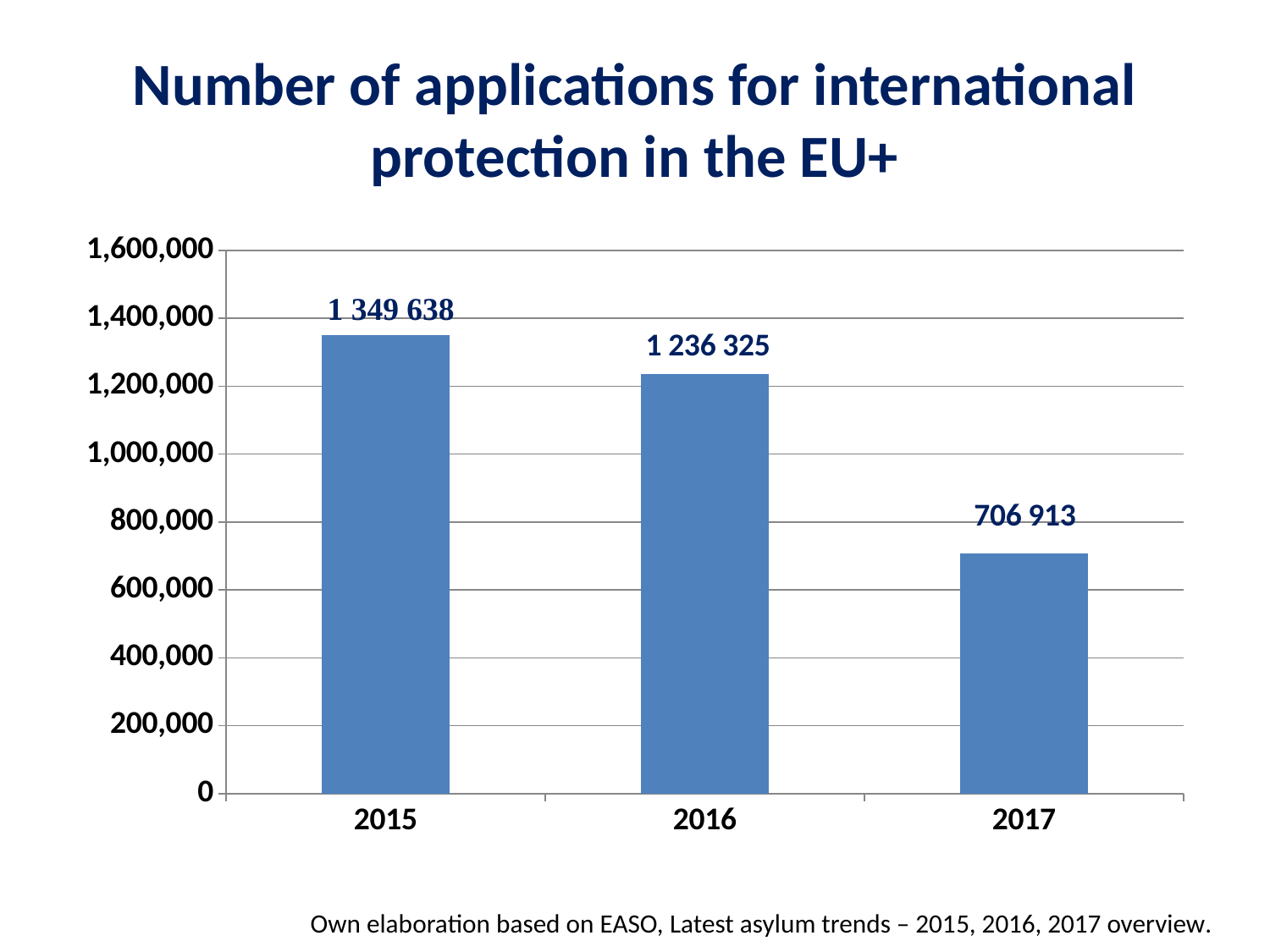
Which year has the highest number of applications? 2015 What is the difference between the number of applications in 2016 and 2017? 529 412 How many years are shown on the chart? 3 Which year has the lowest number of applications? 2017 What is the difference between the number of applications in 2015 and 2016? 113 313 Is the value for 2017 greater or less than 800,000? less What is the number of applications for international protection in the EU+ in 2016? 1 236 325 Do the values rise or fall from 2015 to 2017? fall What kind of chart is shown on the slide? bar chart What is the number of applications for international protection in the EU+ in 2017? 706 913 What is the number of applications for international protection in the EU+ in 2015? 1 349 638 Which year had more applications, 2016 or 2017? 2016